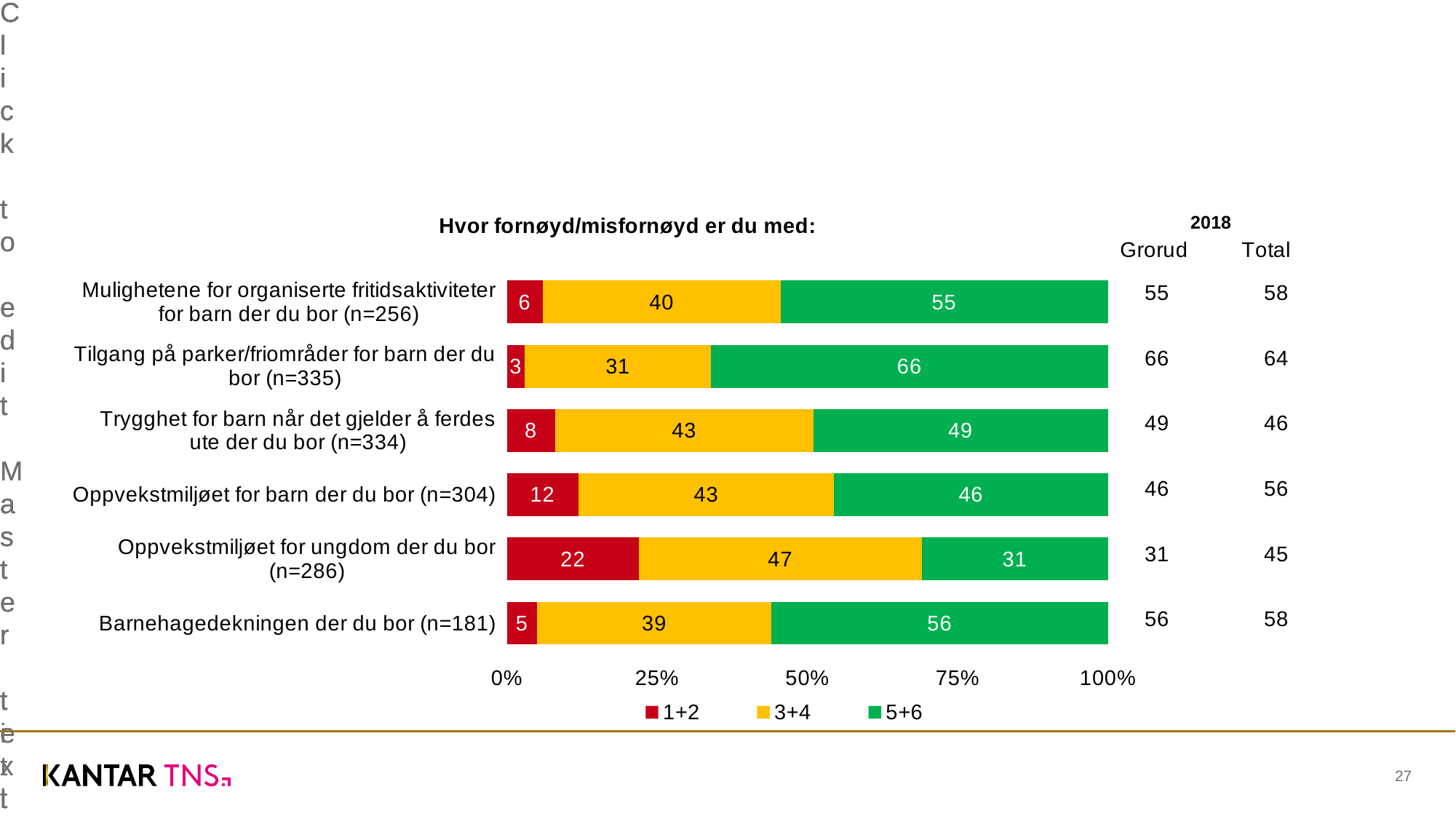
How many series does the legend list? 3 What is the 3+4 value for "Trygghet for barn når det gjelder å ferdes ute der du bor (n=334)"? 43 What is the 5+6 value for "Tilgang på parker/friområder for barn der du bor (n=335)"? 66 Which category has the lowest 5+6 value? Oppvekstmiljøet for ungdom der du bor (n=286) Which category has the highest 5+6 value? Tilgang på parker/friområder for barn der du bor (n=335) What kind of chart is shown on the slide? Stacked bar chart How many categories are plotted in the chart? 6 What is the 1+2 value for "Oppvekstmiljøet for ungdom der du bor (n=286)"? 22 What is the total of the stacked bar for "Mulighetene for organiserte fritidsaktiviteter for barn der du bor (n=256)"? 101 What is the difference between the 5+6 values for "Barnehagedekningen der du bor (n=181)" and "Oppvekstmiljøet for barn der du bor (n=304)"? 10 Which is larger: the 1+2 value for "Oppvekstmiljøet for barn der du bor (n=304)" or for "Mulighetene for organiserte fritidsaktiviteter for barn der du bor (n=256)"? Oppvekstmiljøet for barn der du bor (n=304) What is the title of the chart? Hvor fornøyd/misfornøyd er du med: